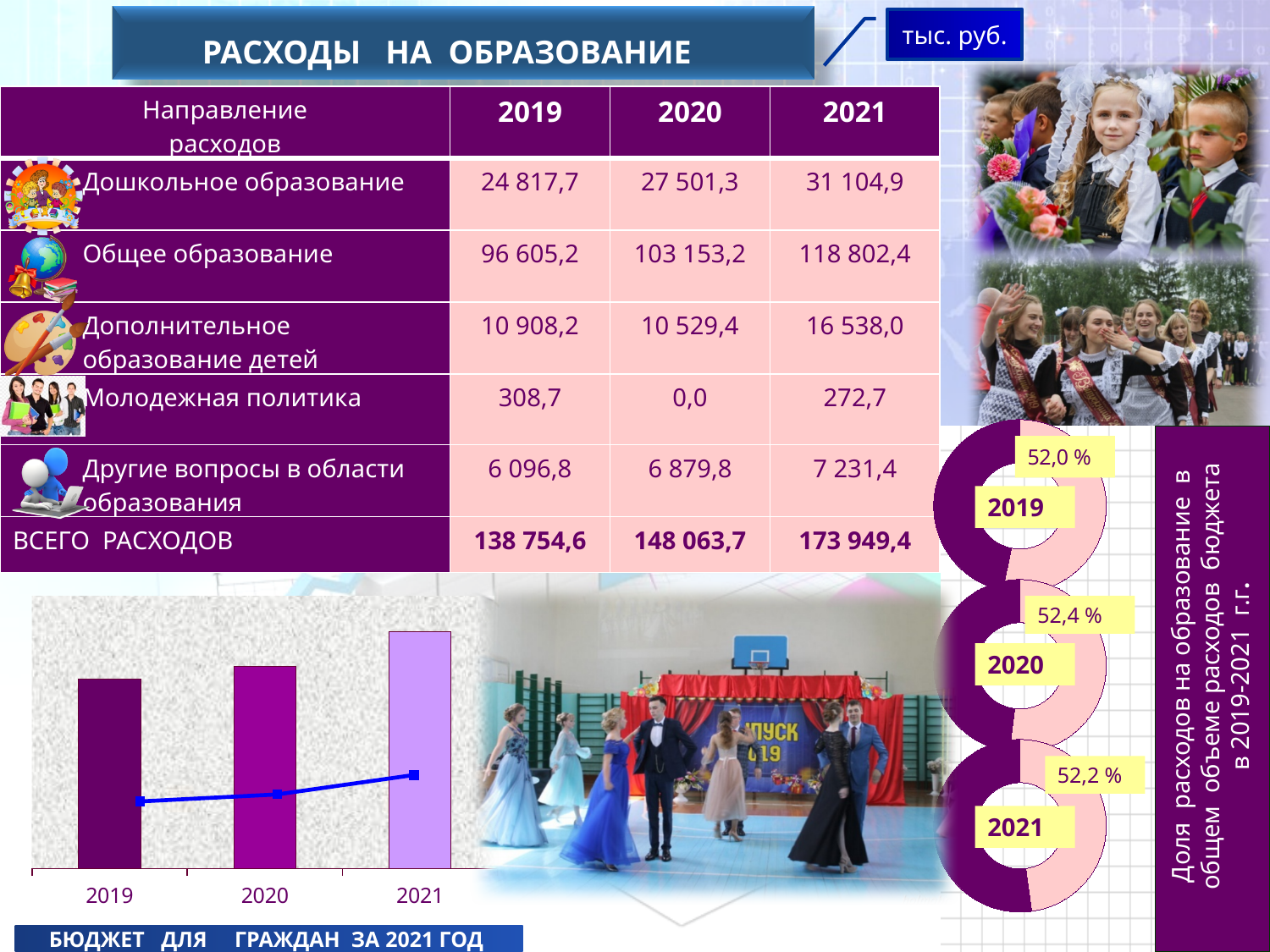
In the donut charts on the right of the slide, what share is shown for 2021? 52,2 % In the donut charts on the right of the slide, what is the difference between the 2020 share and the 2019 share? 0,4 % In the donut charts on the right of the slide, what share is shown for 2020? 52,4 % In the donut charts on the right of the slide, what share is shown for 2019? 52,0 % How many bars does the bar chart at the bottom left of the slide have? 3 In the bar chart at the bottom left, which year has the tallest bar? 2021 In the bar chart at the bottom left, which bar is taller, 2020 or 2021? 2021 Among the donut charts on the right of the slide, which year has the highest share? 2020 What kind of chart is shown at the bottom left of the slide? bar chart Among the donut charts on the right of the slide, which year has the lowest share? 2019 In the bar chart at the bottom left, do the bars rise or fall from 2019 to 2021? rise In the bar chart at the bottom left, which year has the shortest bar? 2019